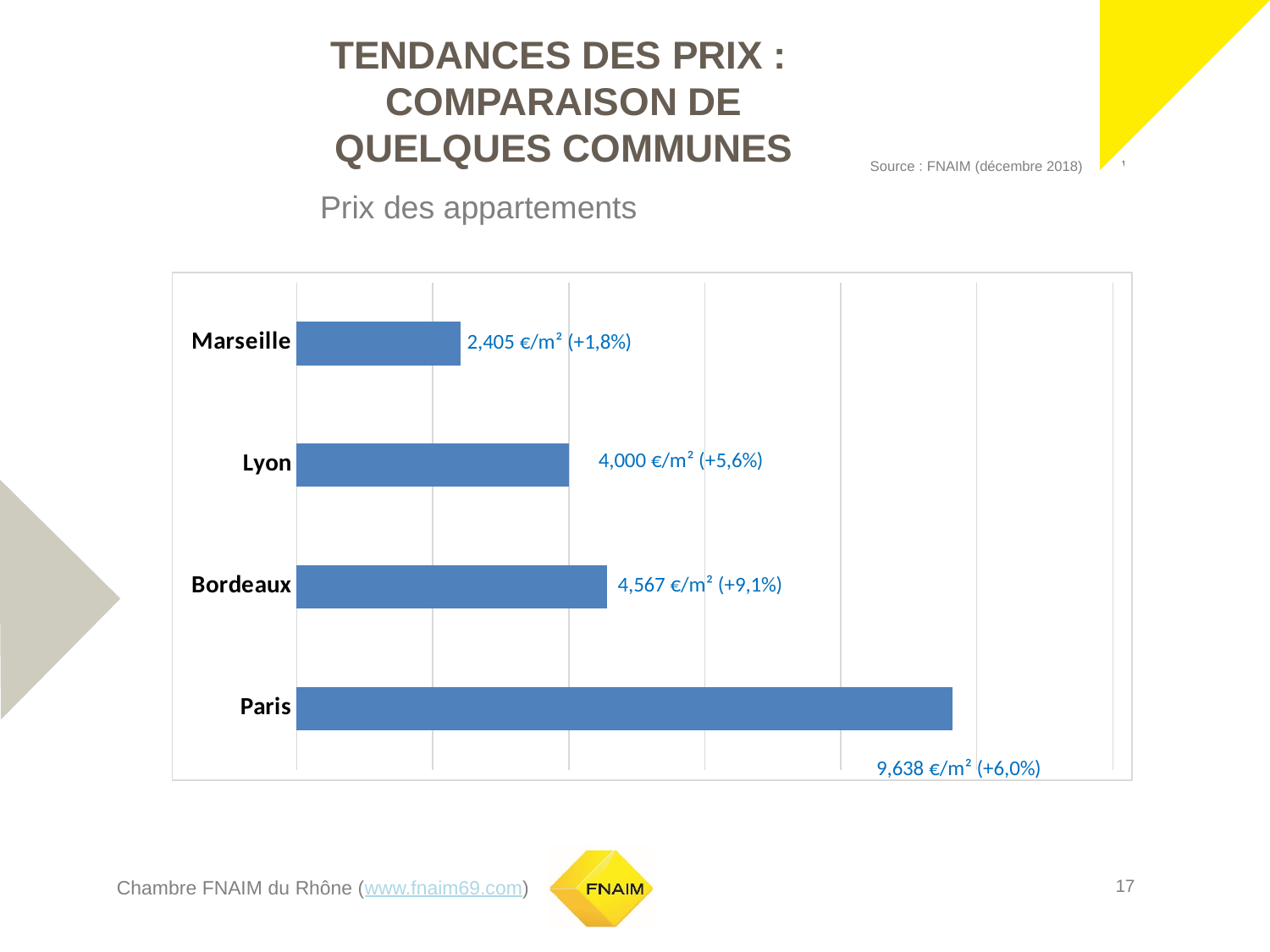
What type of chart is used to show apartment prices? Bar chart Which city has the highest apartment price per m²? Paris Which city shows the largest percentage increase in price? Bordeaux What is the apartment price per m² shown for Lyon? 4,000 €/m² How many cities are shown in the chart? 4 What is the difference in price per m² between Bordeaux and Lyon? 567 €/m² What is the apartment price per m² shown for Marseille? 2,405 €/m² What percentage change is shown next to the Paris bar? +6,0% What is the apartment price per m² shown for Bordeaux? 4,567 €/m² What is the difference in price per m² between Paris and Marseille? 7,233 €/m² Which city has the lowest apartment price per m²? Marseille Which city has the larger apartment price per m², Bordeaux or Lyon? Bordeaux